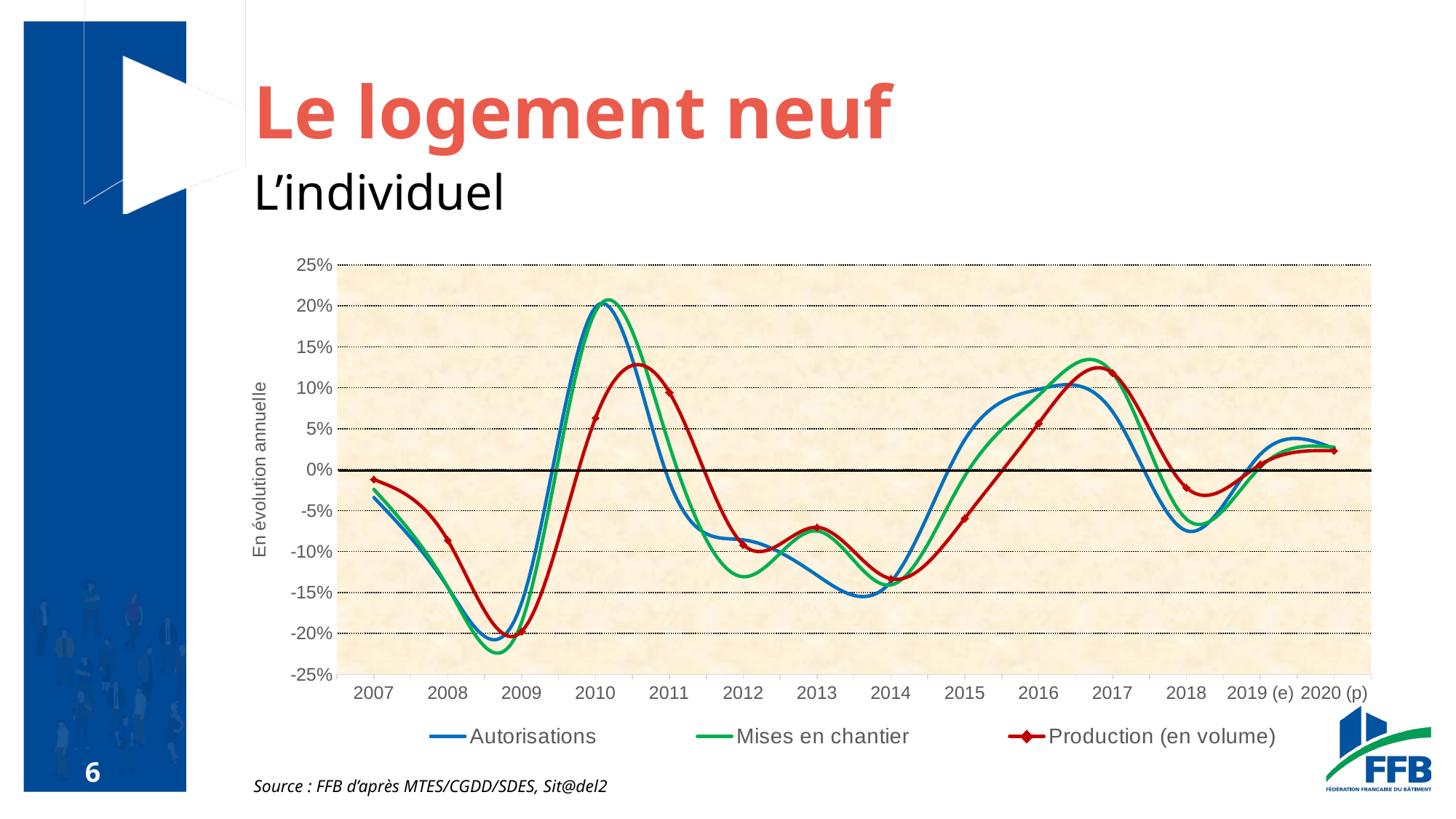
Is the value for Mises en chantier in 2012 greater or less than -10%? less Is the value for Production (en volume) in 2018 greater or less than 0%? less Is the value for Production (en volume) in 2011 greater or less than 5%? greater What kind of chart is shown on the slide? Line chart How many series does the legend list? 3 In 2010, which is larger: Autorisations or Production (en volume)? Autorisations How many years are shown along the x axis? 14 In which year does Production (en volume) reach its lowest value? 2009 What is the label of the vertical axis? En évolution annuelle Which series is drawn with diamond markers? Production (en volume) In which year does Autorisations reach its highest value? 2010